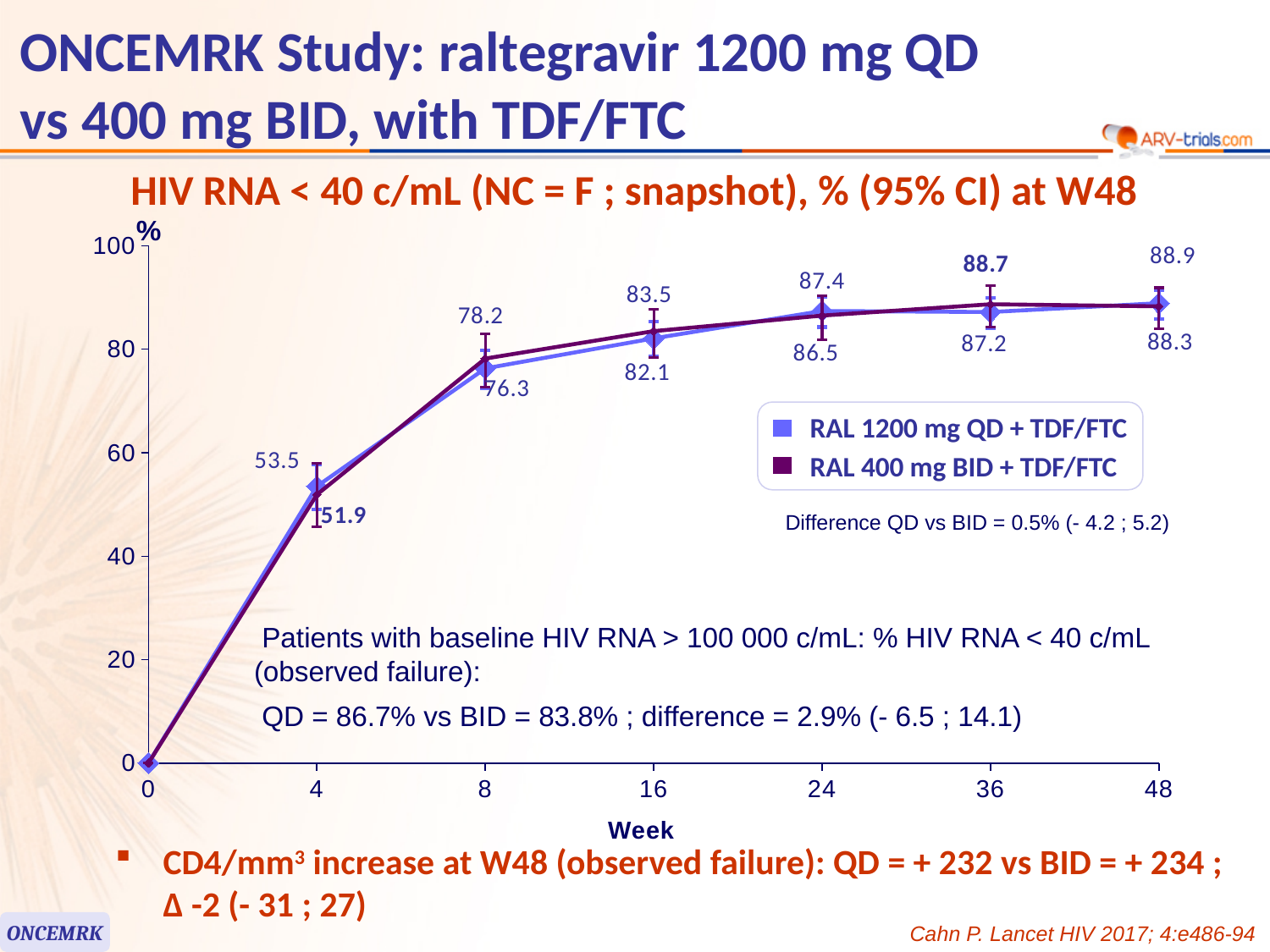
What is the value for RAL 400 mg BID + TDF/FTC at week 36? 88.7 How many week time points are marked on the x axis? 7 How many series does the legend list? 2 What is the value for RAL 1200 mg QD + TDF/FTC at week 48? 88.9 Do the values rise or fall from week 0 to week 48? Rise What is the value for RAL 1200 mg QD + TDF/FTC at week 4? 53.5 Are the values at week 24 greater or less than 80? greater What is the difference between the two series' values at week 4 (53.5 vs 51.9)? 1.6 What is the value for RAL 400 mg BID + TDF/FTC at week 48? 88.3 What kind of chart is shown on the slide? Line chart What is the highest data label shown on the chart? 88.9 Which two treatment arms are listed in the legend? RAL 1200 mg QD + TDF/FTC and RAL 400 mg BID + TDF/FTC